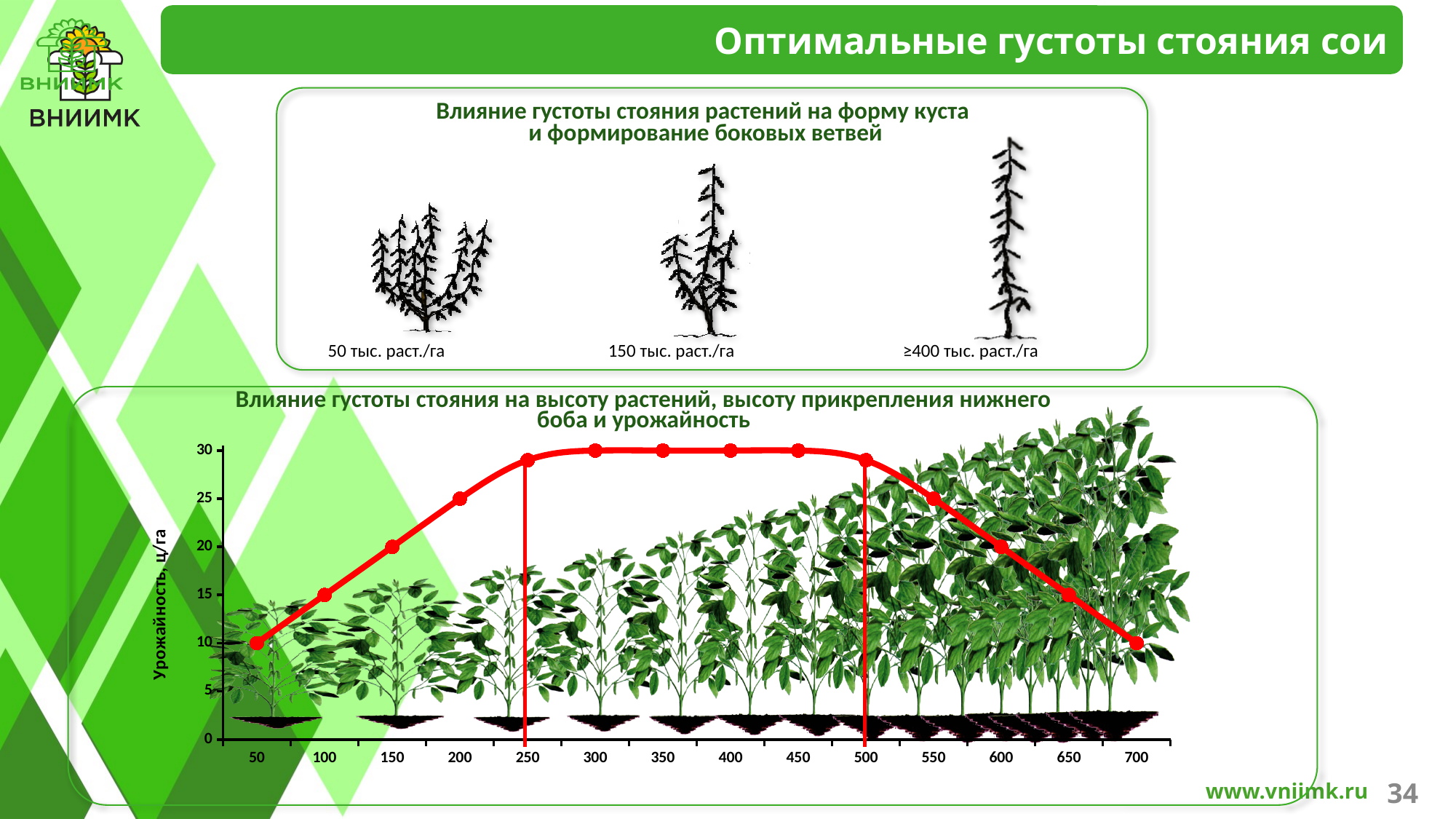
What is the yield at a plant density of 150 on the line chart? 20 What is the yield at a plant density of 600 on the line chart? 20 What kind of chart is shown in the lower panel of the slide? line chart How many data points are plotted on the red line in the chart? 14 Is the yield at a plant density of 650 greater or less than 20? less What is the yield at a plant density of 300 on the line chart? 30 Which is larger on the line chart: the yield at density 200 or the yield at density 550? They are equal (25) What is the yield (Урожайность) at a plant density of 50 on the line chart? 10 What is the difference between the yield at density 400 and the yield at density 100? 15 What is the label of the vertical axis of the line chart? Урожайность, ц/га Is the yield at a plant density of 250 greater or less than 25? greater What is the yield at a plant density of 700 on the line chart? 10